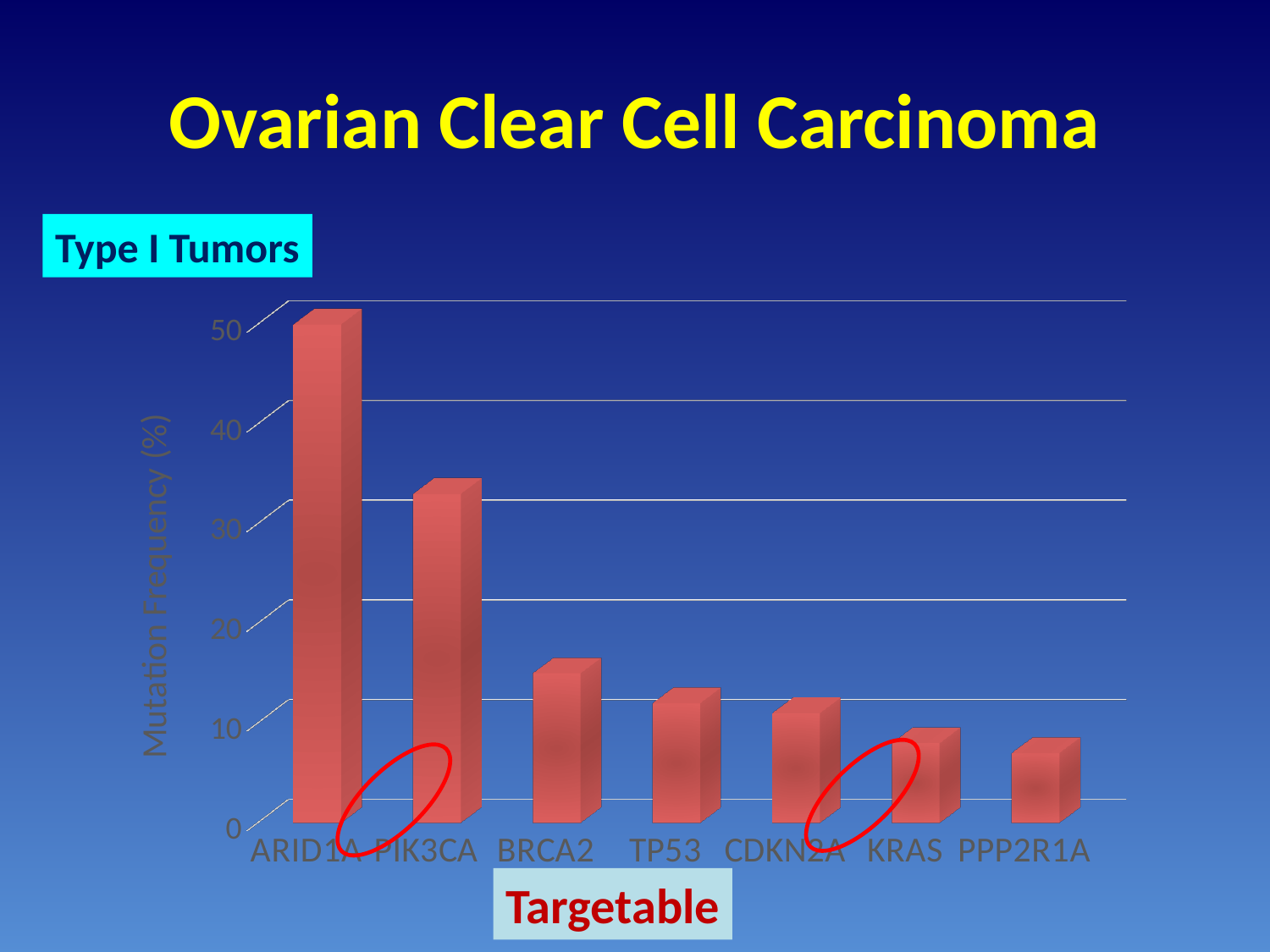
Is the mutation frequency for PIK3CA greater or less than 20? greater Is the mutation frequency for PIK3CA greater or less than 40? less Is the mutation frequency for ARID1A greater or less than 40? greater What kind of chart is shown on the slide? bar chart What is the title of the vertical axis of the chart? Mutation Frequency (%) Which has a higher mutation frequency, BRCA2 or KRAS? BRCA2 Which gene has the lowest mutation frequency in the chart? PPP2R1A Which has a higher mutation frequency, ARID1A or PIK3CA? ARID1A Do the mutation frequencies rise or fall moving from left to right along the x axis? fall Which gene has the highest mutation frequency in the chart? ARID1A How many genes are shown on the x axis of the chart? 7